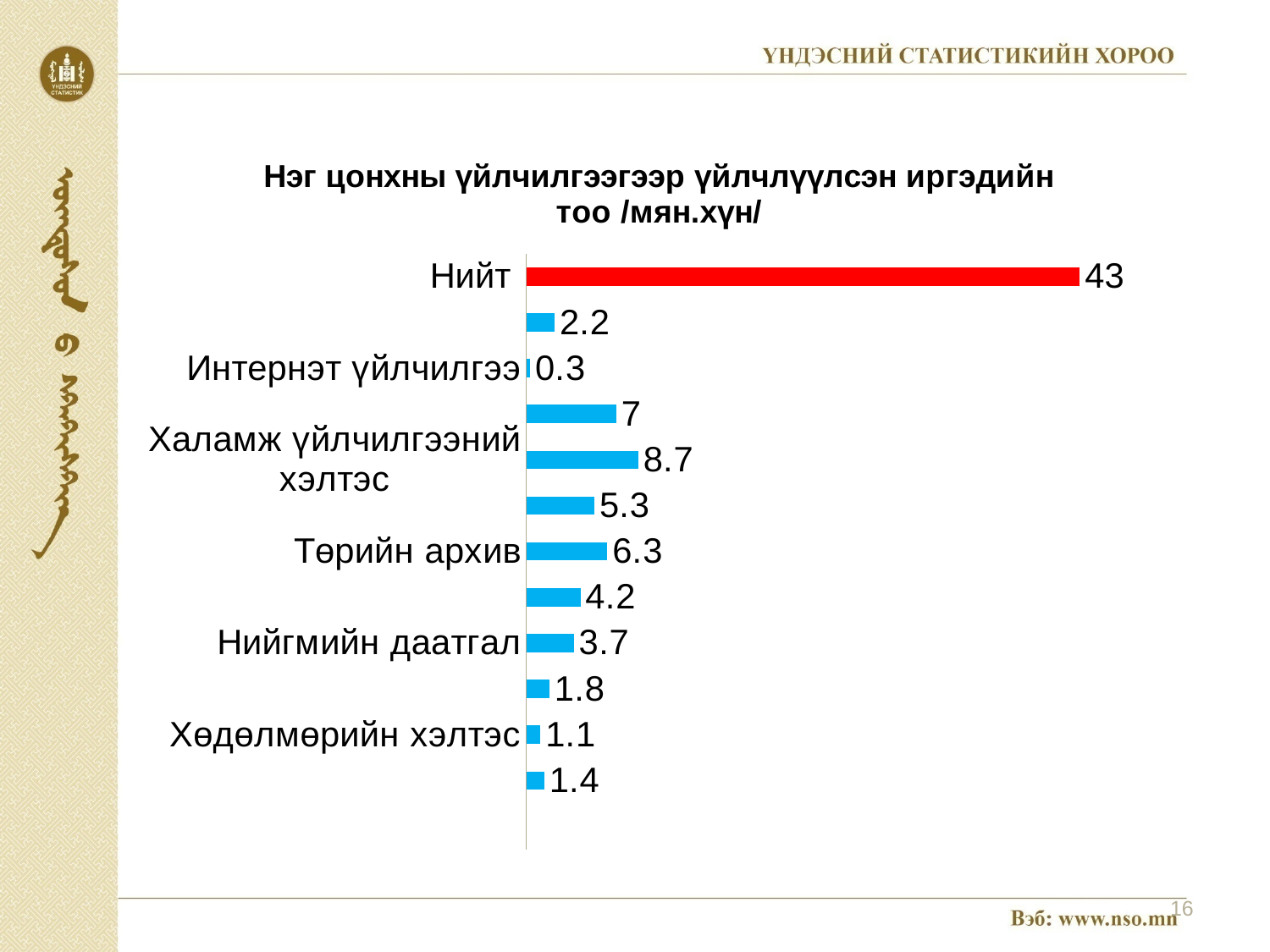
Which is larger, the value for Нийгмийн даатгал or the value for Хөдөлмөрийн хэлтэс? Нийгмийн даатгал What is the value for Интернэт үйлчилгээ? 0.3 Which category has the lowest value? Интернэт үйлчилгээ What is the value for Нийгмийн даатгал? 3.7 What is the value for Халамж үйлчилгээний хэлтэс? 8.7 What is the value for Нийт? 43 What kind of chart is shown on the slide? bar chart How many bars are plotted in the chart? 12 What is the value for Төрийн архив? 6.3 Which category has the highest value? Нийт What is the value for Хөдөлмөрийн хэлтэс? 1.1 What is the difference between the values for Халамж үйлчилгээний хэлтэс and Төрийн архив? 2.4